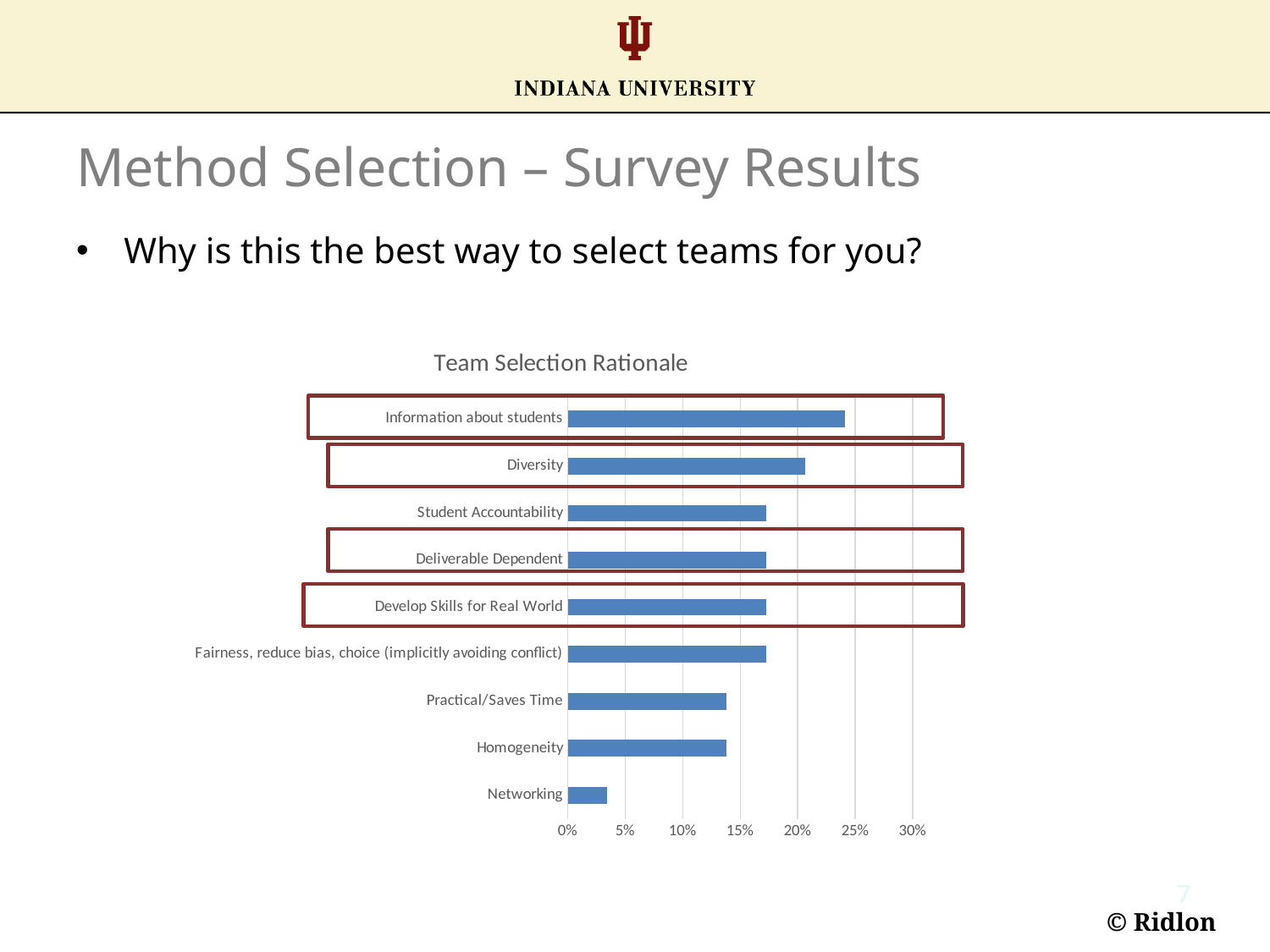
Is the value for Information about students greater or less than 20%? greater Which category has the lowest value? Networking Which is larger, the value for Practical/Saves Time or the value for Networking? Practical/Saves Time Is the value for Diversity greater or less than 25%? less What is the highest value shown on the horizontal axis? 30% Is the value for Networking greater or less than 5%? less Which category has the highest value? Information about students Which is larger, the value for Information about students or the value for Diversity? Information about students How many categories are plotted in the chart? 9 What is the title of the chart? Team Selection Rationale What kind of chart is shown on the slide? Bar chart